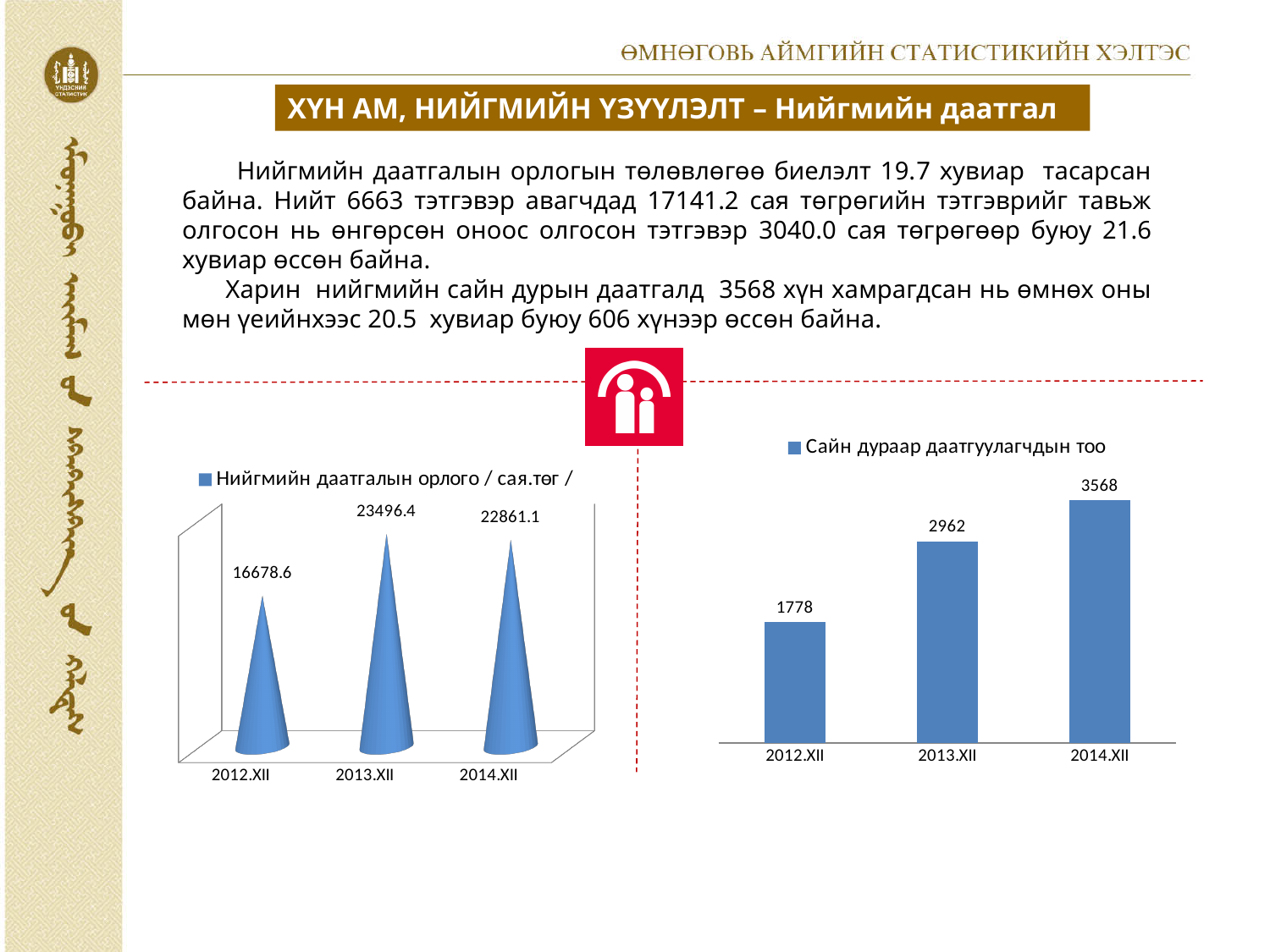
In the right chart (Сайн дураар даатгуулагчдын тоо), what is the value for 2014.XII? 3568 In the left chart (Нийгмийн даатгалын орлого / сая.төг /), what is the difference between the 2013.XII and 2014.XII values? 635.3 In the right chart (Сайн дураар даатгуулагчдын тоо), how many periods are shown on the x axis? 3 In the right chart (Сайн дураар даатгуулагчдын тоо), what is the value for 2012.XII? 1778 In the left chart (Нийгмийн даатгалын орлого / сая.төг /), which period has the lowest value? 2012.XII In the left chart (Нийгмийн даатгалын орлого / сая.төг /), what is the value for 2012.XII? 16678.6 In the right chart (Сайн дураар даатгуулагчдын тоо), do the values rise or fall from 2012.XII to 2014.XII? rise Which is larger in the left chart (Нийгмийн даатгалын орлого / сая.төг /): the value for 2012.XII or for 2014.XII? 2014.XII In the right chart (Сайн дураар даатгуулагчдын тоо), how much higher is the 2014.XII value than the 2013.XII value? 606 What kind of chart is the right chart (Сайн дураар даатгуулагчдын тоо)? bar chart In the left chart (Нийгмийн даатгалын орлого / сая.төг /), which period has the highest value? 2013.XII In the left chart (Нийгмийн даатгалын орлого / сая.төг /), what is the value for 2013.XII? 23496.4